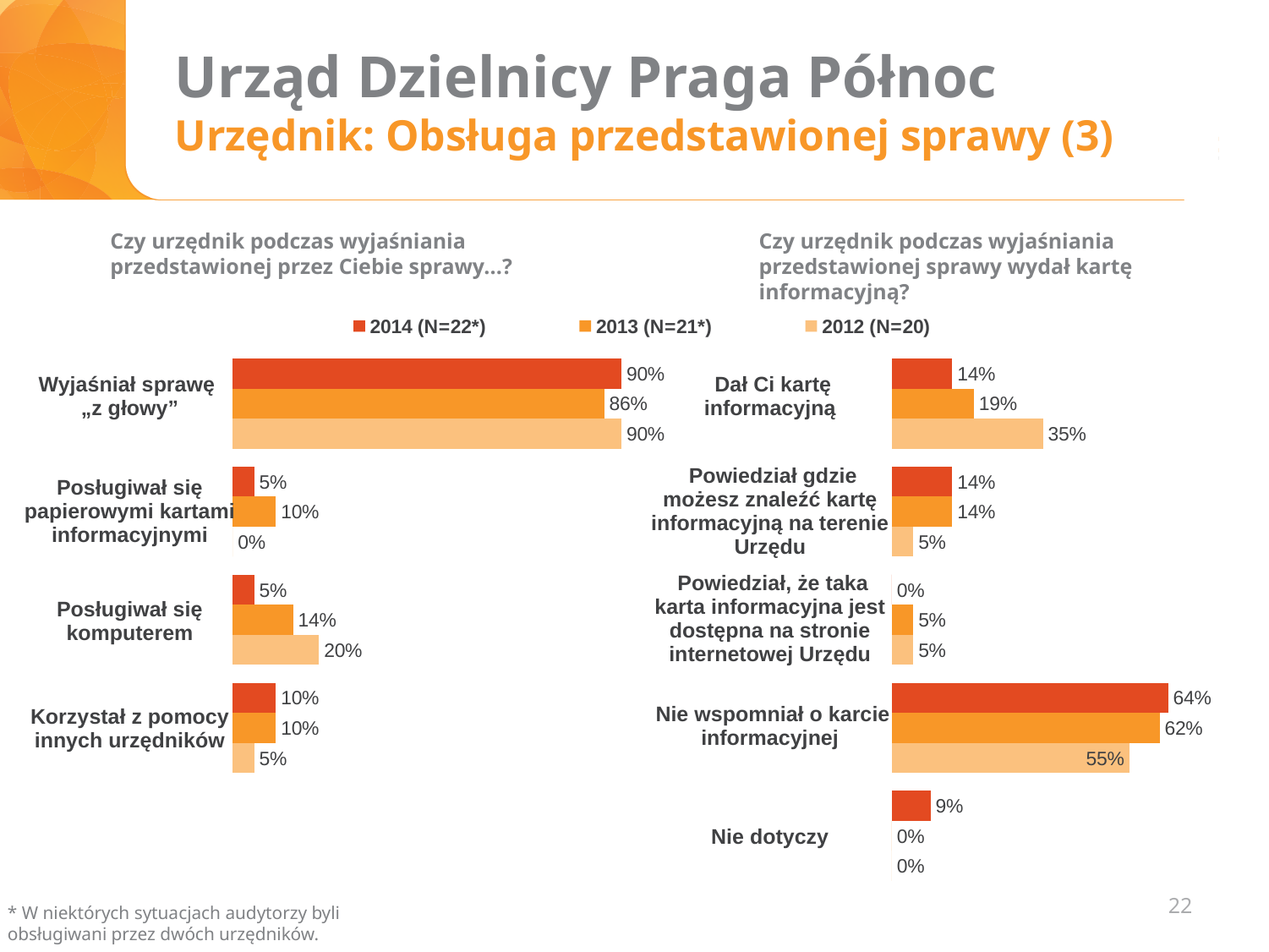
In the right chart, which category has the lowest 2014 value? Powiedział, że taka karta informacyjna jest dostępna na stronie internetowej Urzędu In the left chart, what is the 2012 value for "Posługiwał się komputerem"? 20% In the left chart, how many categories are shown? 4 In the right chart, is the 2013 value for "Dał Ci kartę informacyjną" larger or smaller than the 2012 value? smaller In the right chart, what is the difference between the 2014 and 2012 values for "Nie wspomniał o karcie informacyjnej"? 9% In the right chart ("Czy urzędnik podczas wyjaśniania przedstawionej sprawy wydał kartę informacyjną?"), what is the 2012 value for "Dał Ci kartę informacyjną"? 35% What type of chart is used on this slide? Bar chart In the right chart, what is the 2014 value for "Nie wspomniał o karcie informacyjnej"? 64% In the left chart ("Czy urzędnik podczas wyjaśniania przedstawionej przez Ciebie sprawy...?"), what is the 2013 value for "Wyjaśniał sprawę „z głowy”"? 86% In the left chart, which category has the highest 2014 value? Wyjaśniał sprawę „z głowy” In the left chart, what is the difference between the 2012 and 2014 values for "Posługiwał się komputerem"? 15% How many series does the legend list? 3